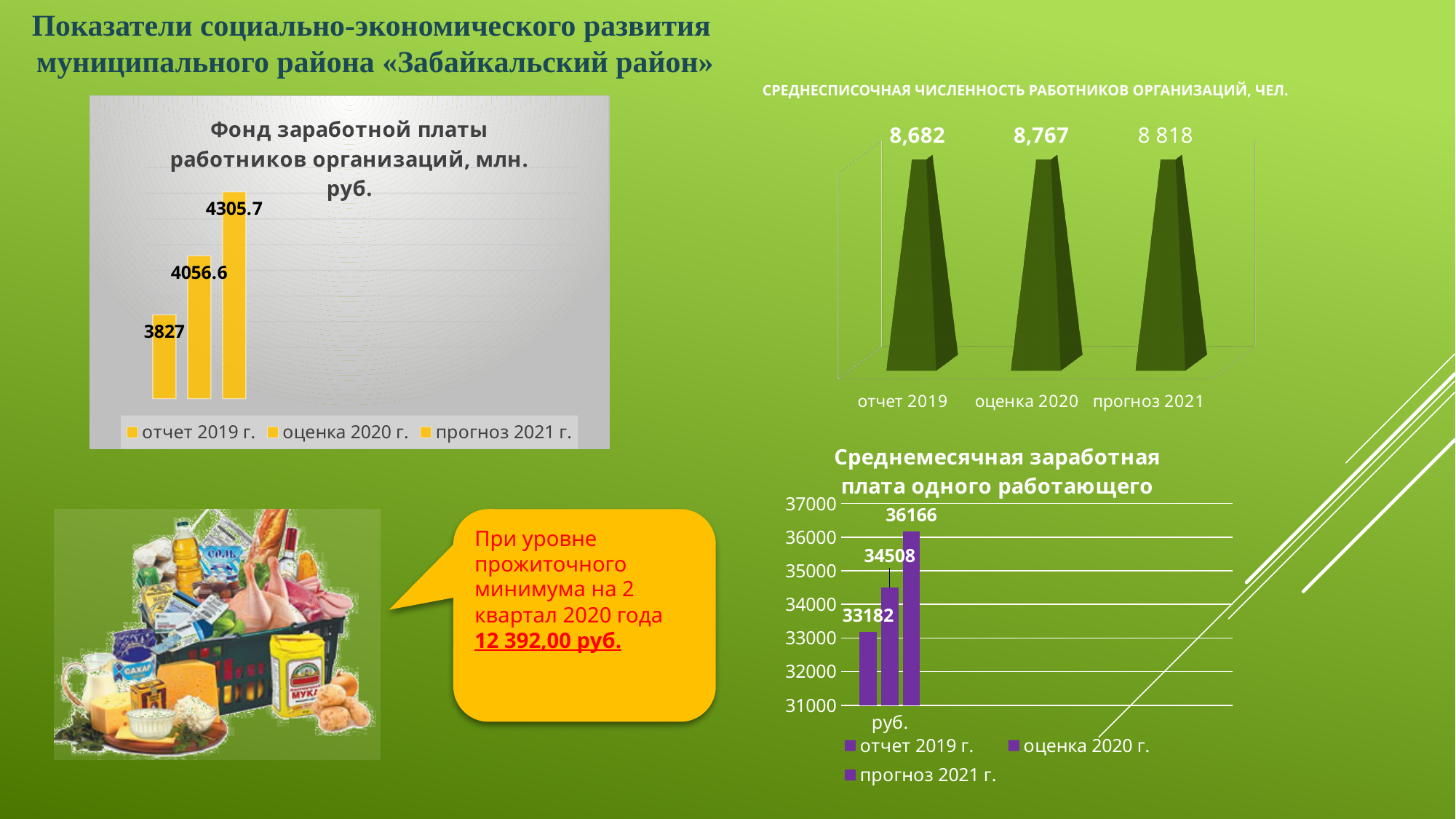
In the chart 'Среднемесячная заработная плата одного работающего', what is the value for оценка 2020 г.? 34508 In the chart 'Среднесписочная численность работников организаций, чел.', which category has the lowest value? отчет 2019 In the chart 'Среднемесячная заработная плата одного работающего', what is the difference between прогноз 2021 г. and отчет 2019 г.? 2984 In the chart 'Фонд заработной платы работников организаций, млн. руб.', what is the difference between прогноз 2021 г. and отчет 2019 г.? 478.7 What kind of chart is 'Среднемесячная заработная плата одного работающего'? bar chart In the chart 'Среднесписочная численность работников организаций, чел.', what is the value for оценка 2020? 8,767 In the chart 'Среднемесячная заработная плата одного работающего', which series has the highest value? прогноз 2021 г. In the chart 'Среднесписочная численность работников организаций, чел.', how many bars are plotted? 3 In the chart 'Фонд заработной платы работников организаций, млн. руб.', what is the value for отчет 2019 г.? 3827 In the chart 'Среднесписочная численность работников организаций, чел.', do the values rise or fall from отчет 2019 to прогноз 2021? rise In the chart 'Фонд заработной платы работников организаций, млн. руб.', how many series does the legend list? 3 In the chart 'Фонд заработной платы работников организаций, млн. руб.', what is the value for прогноз 2021 г.? 4305.7